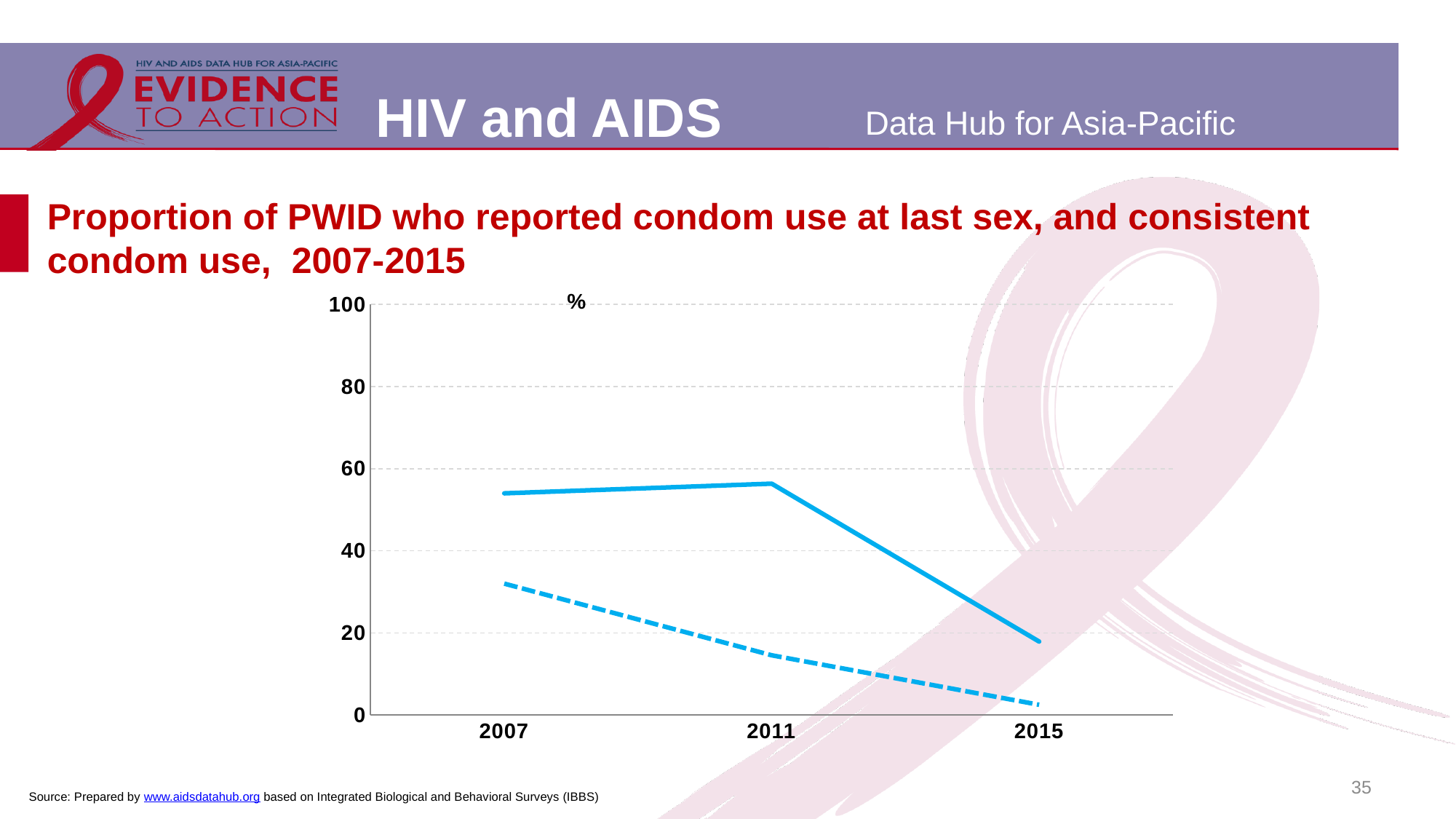
Does the dashed line rise or fall from 2007 to 2015? fall Is the value of the solid line in 2007 greater or less than 40? greater How many years are plotted along the x axis? 3 Is the value of the dashed line in 2011 greater or less than 20? less What kind of chart is shown on the slide? line chart What unit is shown at the top of the y axis? % How many lines (series) are plotted on the chart? 2 Does the solid line rise or fall between 2011 and 2015? fall In which year is the solid line at its lowest value? 2015 In 2007, which line has the larger value, the solid line or the dashed line? solid line In which year is the dashed line at its highest value? 2007 In which year is the dashed line at its lowest value? 2015